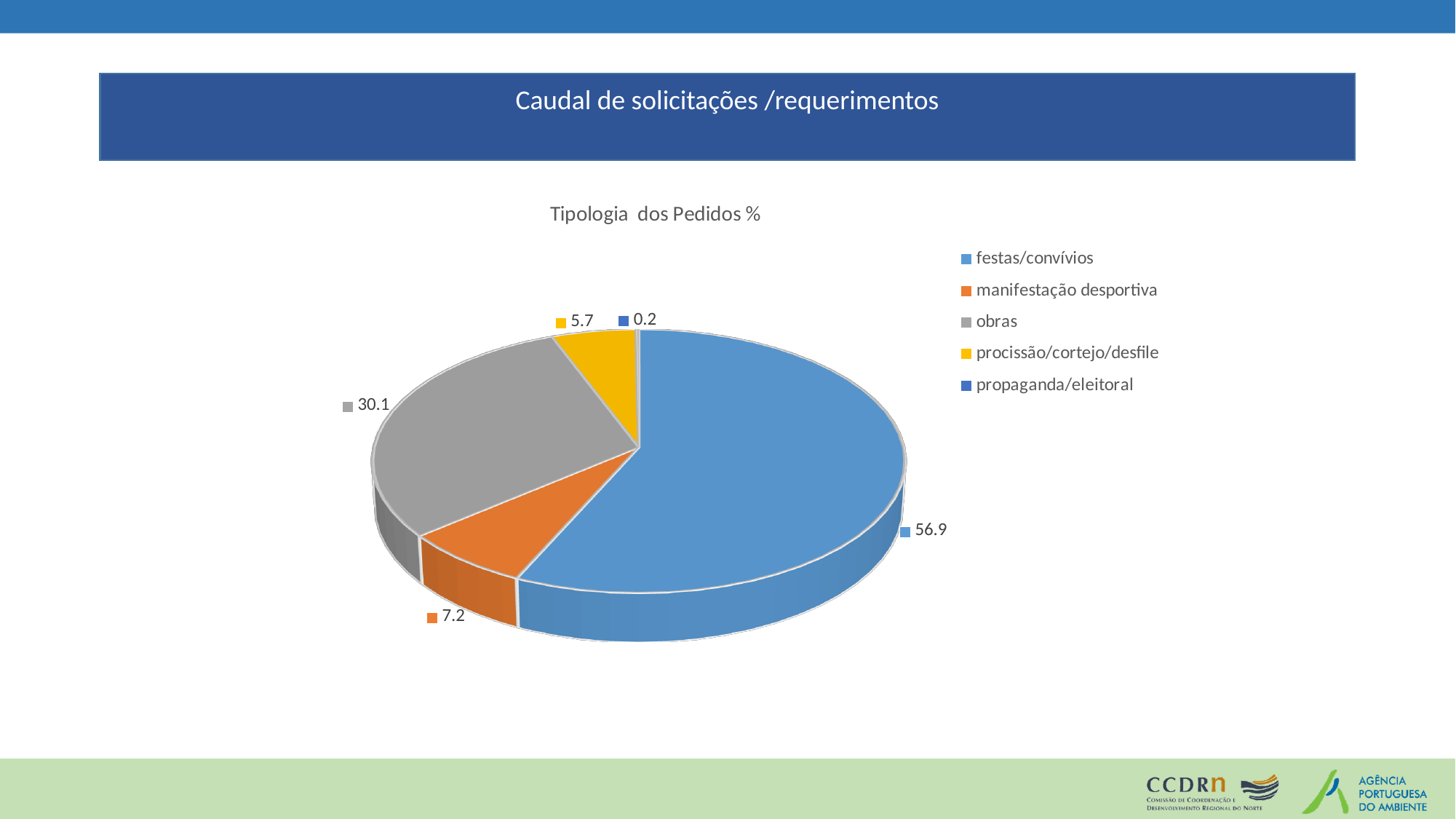
Which category has the smallest slice? propaganda/eleitoral What is the difference between the values for festas/convívios and obras? 26.8 What is the value for propaganda/eleitoral? 0.2 What is the value for obras? 30.1 Which is larger, manifestação desportiva or procissão/cortejo/desfile? manifestação desportiva Which category has the largest slice? festas/convívios What is the title of the chart? Tipologia dos Pedidos % How many categories does the pie chart show? 5 What is the value for manifestação desportiva? 7.2 What kind of chart is shown on the slide? pie chart What is the value for procissão/cortejo/desfile? 5.7 What is the value for festas/convívios? 56.9